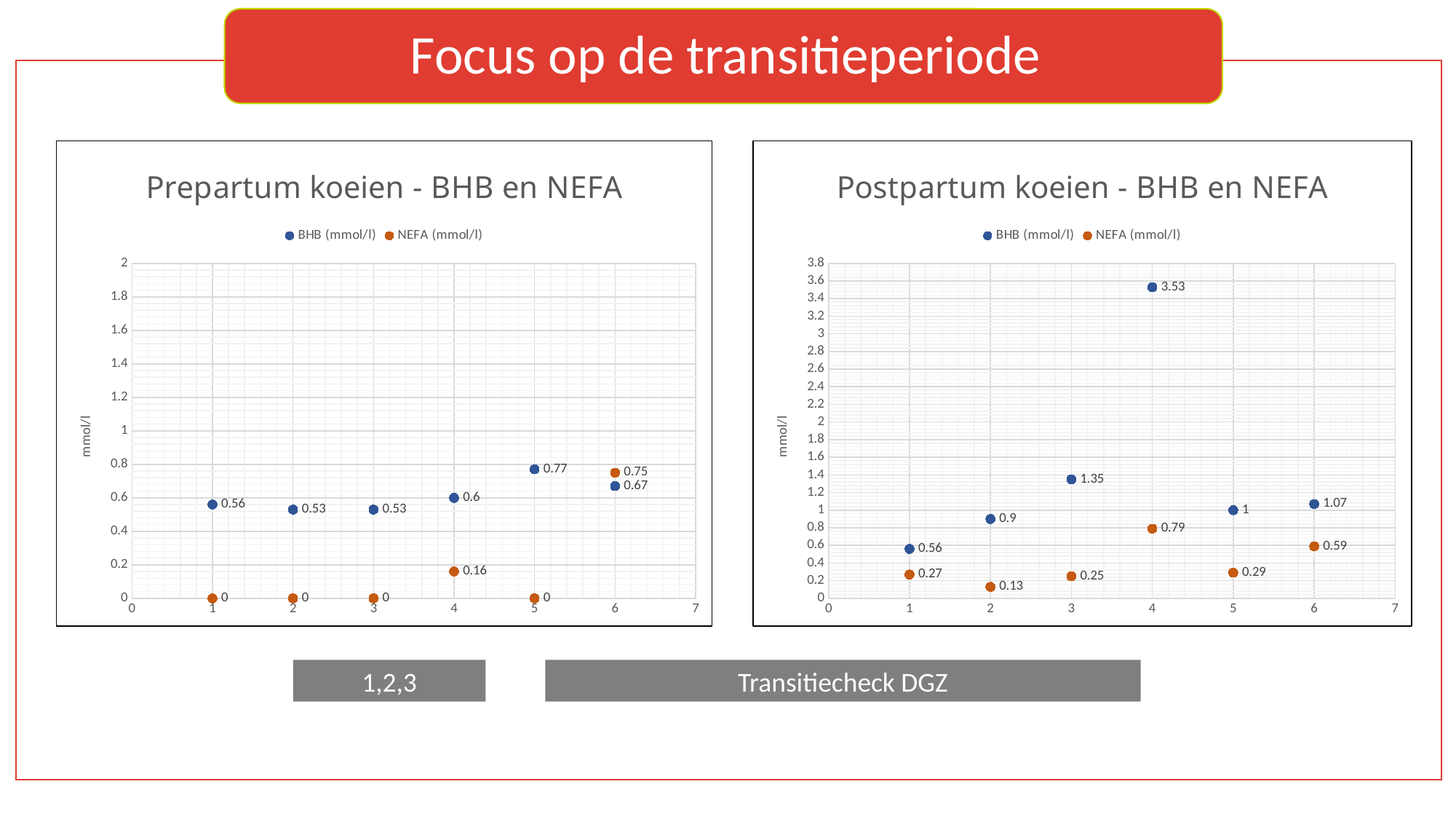
In the Postpartum koeien - BHB en NEFA chart, what is the BHB (mmol/l) value at x = 4? 3.53 What kind of chart is the Postpartum koeien - BHB en NEFA chart? Scatter chart In the Prepartum koeien - BHB en NEFA chart, what is the difference between the BHB value at x = 5 and the BHB value at x = 1? 0.21 In the Postpartum koeien - BHB en NEFA chart, how many BHB (mmol/l) data points are plotted? 6 In the Prepartum koeien - BHB en NEFA chart, what is the NEFA (mmol/l) value at x = 6? 0.75 In the Prepartum koeien - BHB en NEFA chart, at which x value is BHB (mmol/l) highest? 5 In the Prepartum koeien - BHB en NEFA chart, what is the BHB (mmol/l) value at x = 5? 0.77 In the Postpartum koeien - BHB en NEFA chart, what is the NEFA (mmol/l) value at x = 2? 0.13 In the Prepartum koeien - BHB en NEFA chart, how many series does the legend list? 2 In the Postpartum koeien - BHB en NEFA chart, at which x value is NEFA (mmol/l) lowest? 2 In the Postpartum koeien - BHB en NEFA chart, which is larger at x = 6: BHB or NEFA? BHB In the Postpartum koeien - BHB en NEFA chart, what is the difference between the BHB value at x = 4 and the BHB value at x = 3? 2.18